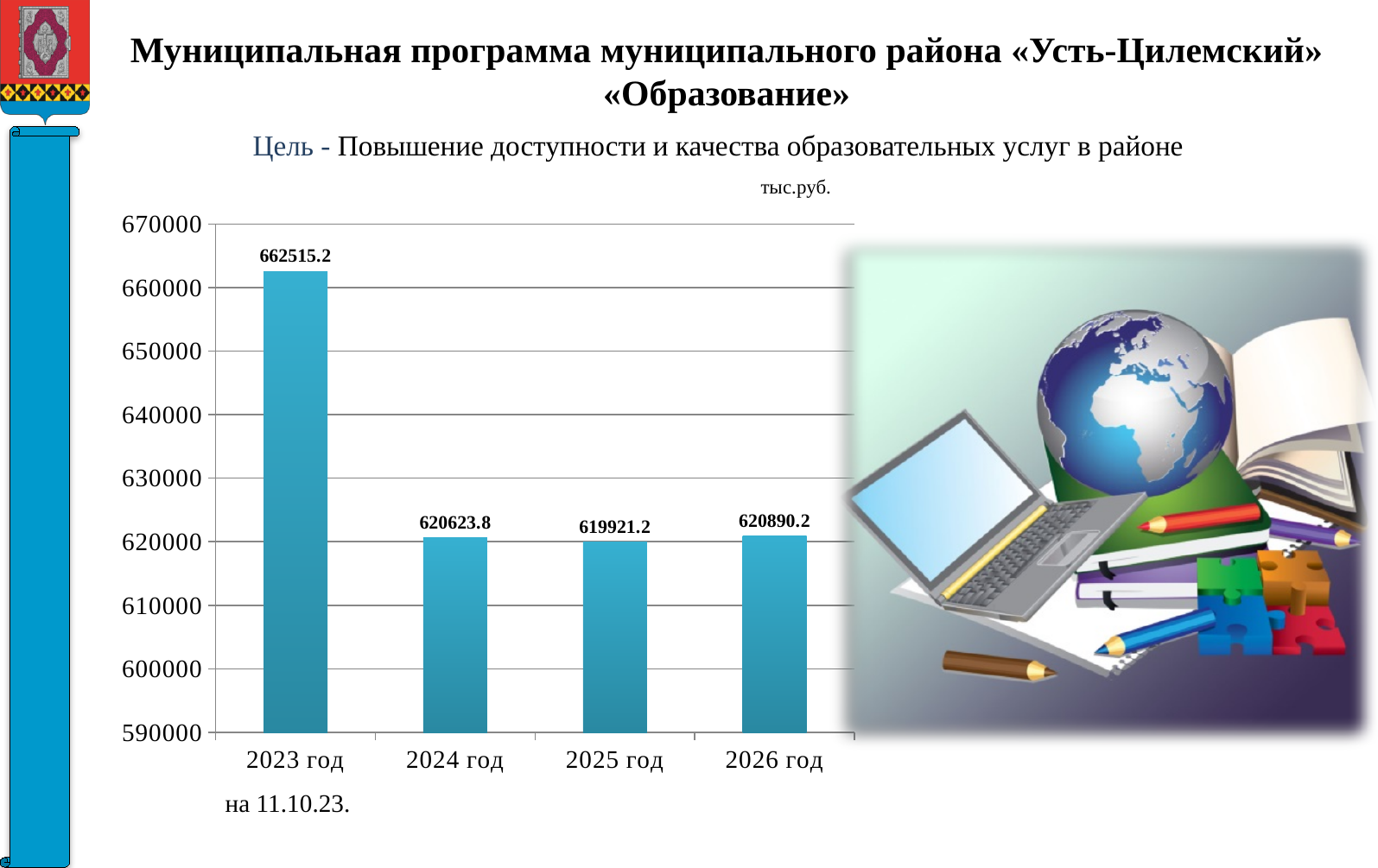
How many years are shown on the x axis? 4 What unit label is printed above the chart? тыс.руб. Is the value for 2023 год greater or less than 650000? greater Which year has the highest value? 2023 год What is the value for 2024 год? 620623.8 Which is larger, the value for 2026 год or the value for 2025 год? 2026 год What is the difference between the values for 2023 год and 2024 год? 41891.4 Which year has the lowest value? 2025 год What is the value for 2025 год? 619921.2 What is the value for 2023 год? 662515.2 What kind of chart is shown on the slide? bar chart What is the value for 2026 год? 620890.2